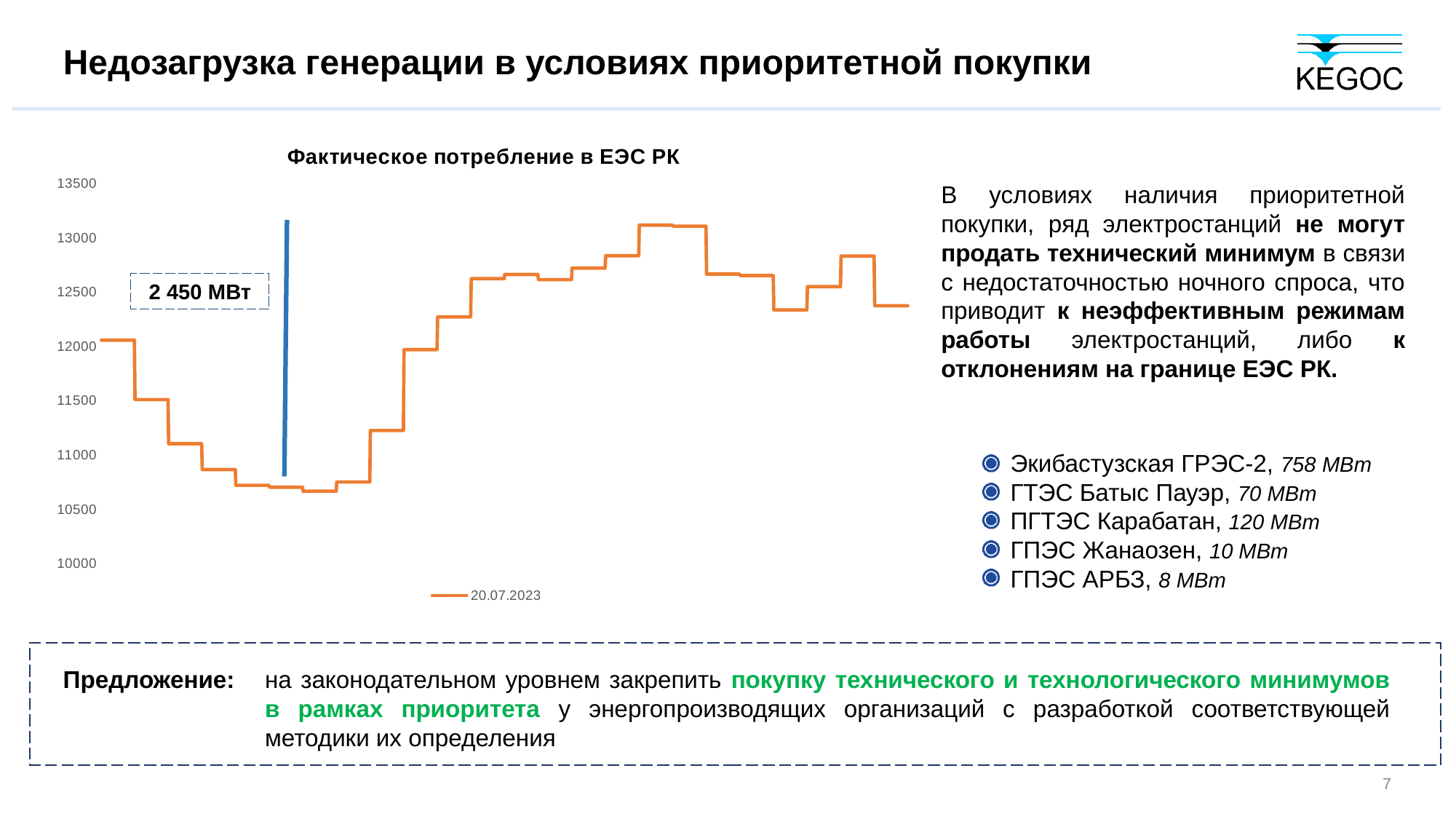
What is the title of the chart? Фактическое потребление в ЕЭС РК Does the line fall or rise over its first few steps from the left? falls Is the highest value reached by the line greater or less than 13000? greater What is the highest tick value shown on the vertical axis? 13500 Is the value at the very end (right end) of the line greater or less than 12000? greater Is the value at the very start (left end) of the line greater or less than 11500? greater What kind of chart is shown on the slide? line chart What is the name of the series shown in the chart legend? 20.07.2023 How many series does the chart legend list? 1